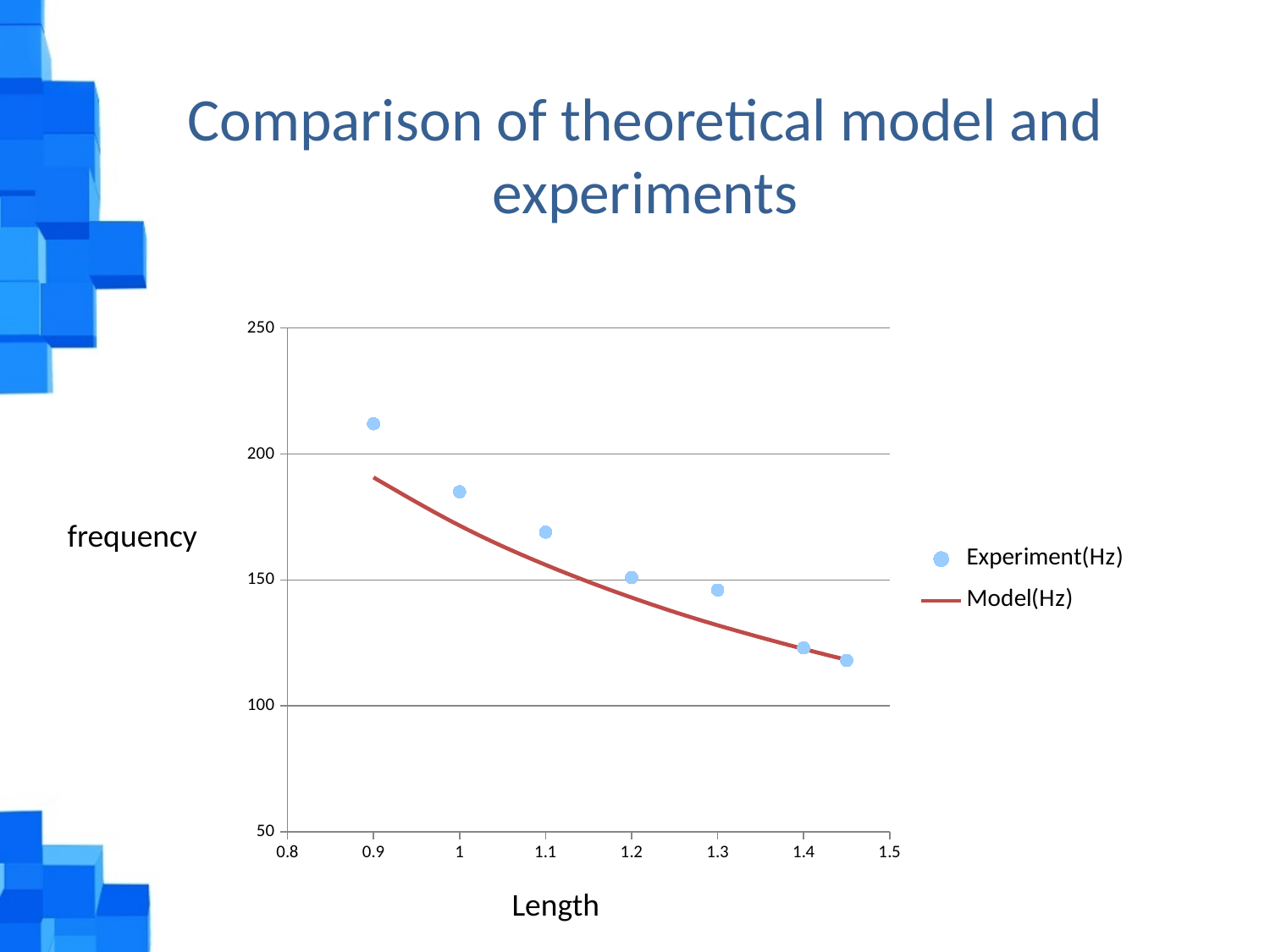
Do the Experiment(Hz) values rise or fall as Length increases? fall Is the Experiment(Hz) value at Length 0.9 greater or less than 200? greater What is the label on the x axis of the chart? Length Is the Experiment(Hz) value at Length 1.45 greater or less than 150? less How many series does the legend list? 2 At which Length is the Experiment(Hz) value highest? 0.9 Is the Model(Hz) value at Length 0.9 greater or less than 200? less At which Length is the Experiment(Hz) value lowest? 1.45 What kind of chart is shown on the slide? scatter chart How many Experiment(Hz) data points are plotted? 7 Which is larger, the Experiment(Hz) value at Length 1.0 or at Length 1.3? Length 1.0